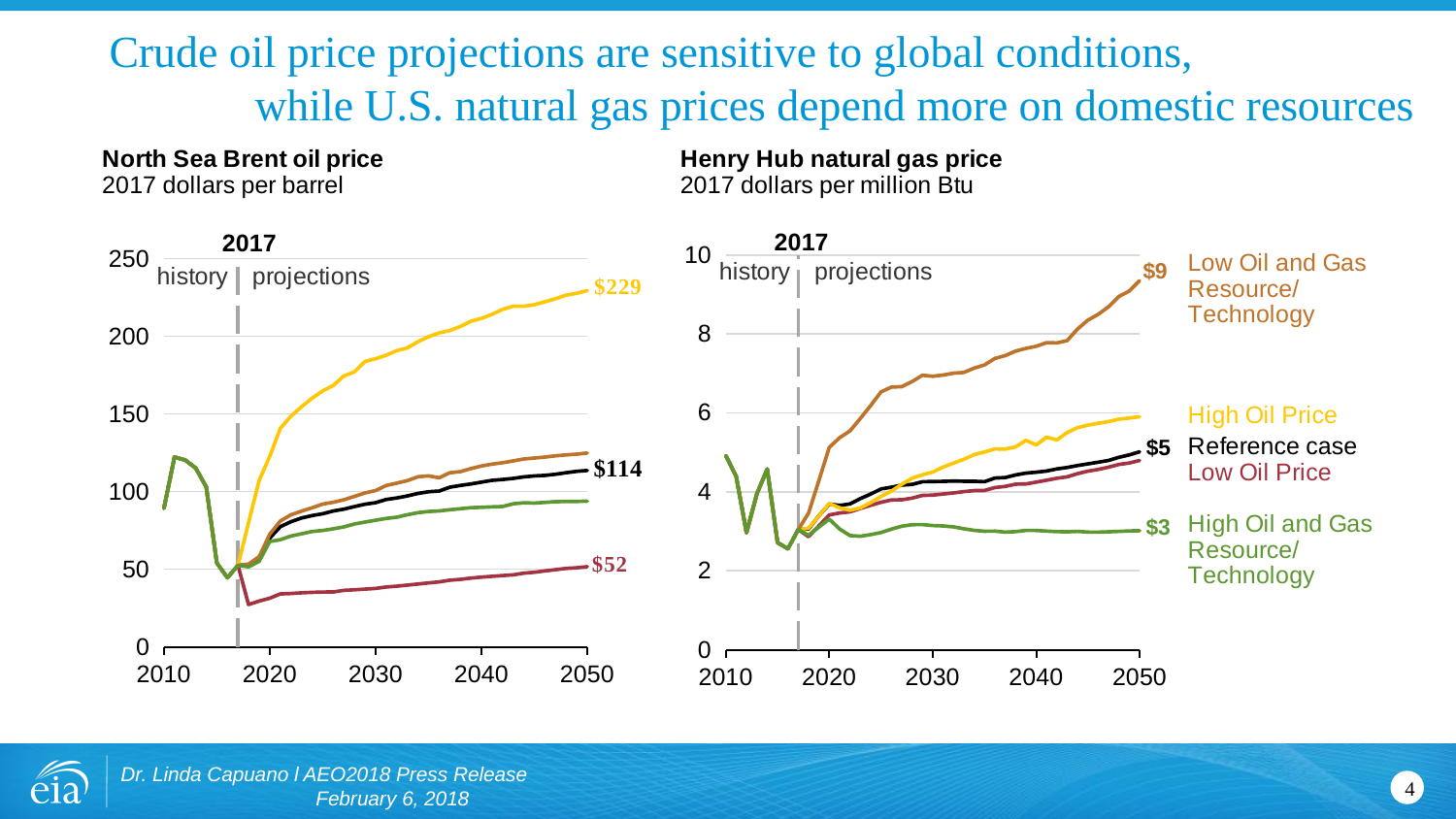
On the North Sea Brent oil price chart, what is the labelled 2050 value of the Low Oil Price (red) line? $52 On the Henry Hub natural gas price chart, what is the difference between the labelled 2050 values of the Low Oil and Gas Resource/Technology line and the High Oil and Gas Resource/Technology line? $6 On the Henry Hub natural gas price chart, what is the labelled 2050 value of the Low Oil and Gas Resource/Technology line? $9 On the Henry Hub natural gas price chart, which case has the highest price in 2050? Low Oil and Gas Resource/Technology On the North Sea Brent oil price chart, is the Low Oil Price (red) line in 2030 greater or less than 50? less On the Henry Hub natural gas price chart, what is the labelled 2050 value of the High Oil and Gas Resource/Technology line? $3 On the North Sea Brent oil price chart, does the High Oil Price line rise or fall from 2020 to 2050? rise On the North Sea Brent oil price chart, what is the difference between the labelled 2050 High Oil Price value and the Reference case value? $115 What kind of chart is the North Sea Brent oil price chart? line chart On the North Sea Brent oil price chart, what is the labelled 2050 value of the High Oil Price (yellow) line? $229 On the North Sea Brent oil price chart, what is the labelled 2050 value of the Reference case (black) line? $114 How many cases does the legend of the Henry Hub natural gas price chart list? 5